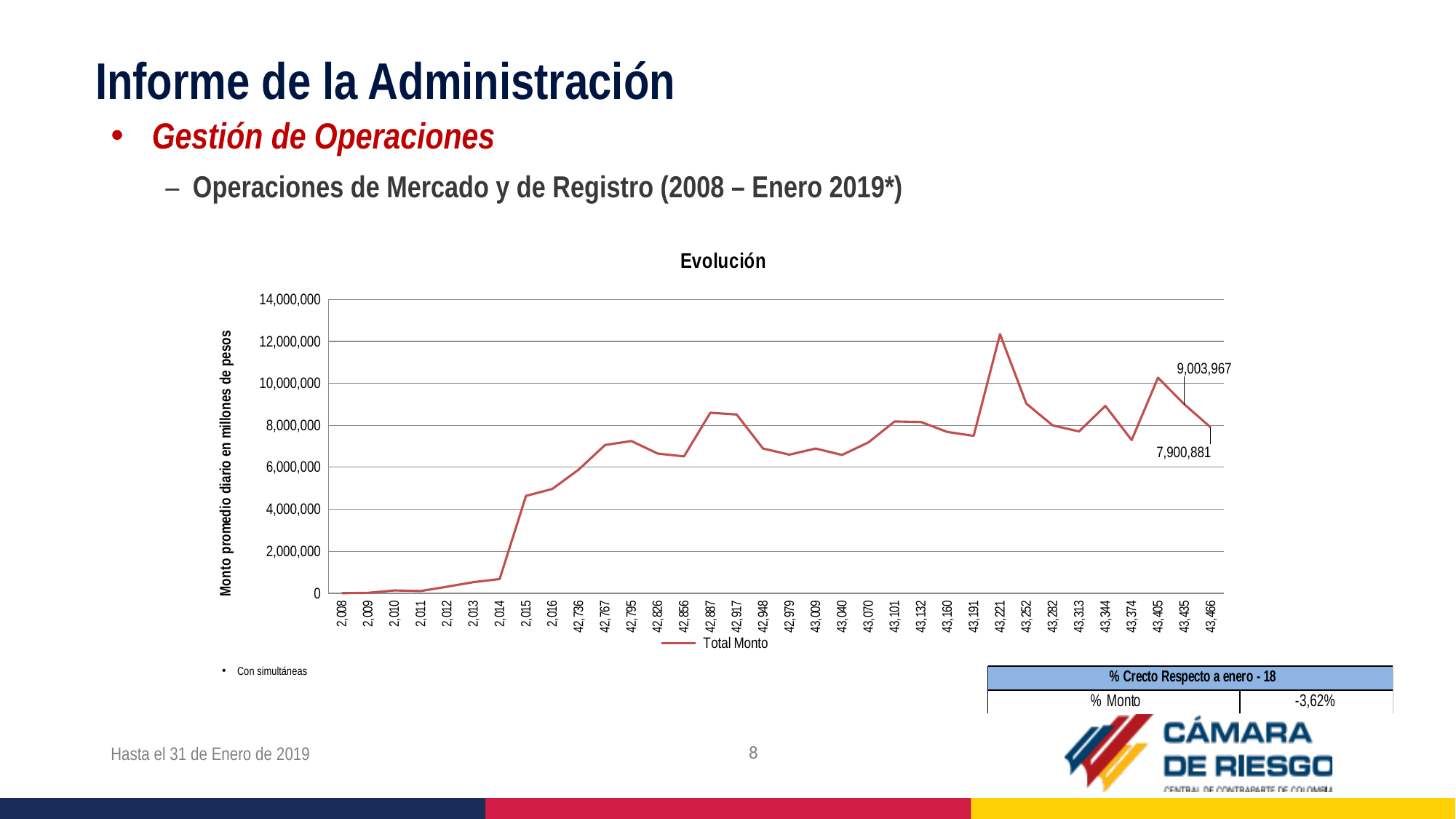
Is the Total Monto value at 2,014 greater or less than 2,000,000? less What is the y-axis title of the "Evolución" chart? Monto promedio diario en millones de pesos How many series does the legend of the "Evolución" chart list? 1 Is the Total Monto value at 43,405 greater or less than 10,000,000? greater What type of chart is the "Evolución" chart? line chart Is the Total Monto value at 43,221 greater or less than 12,000,000? greater Which of the two labelled points, 43,435 or 43,466, has the larger Total Monto value? 43,435 What is the value of Total Monto at 43,435? 9,003,967 At which x-axis label does Total Monto reach its highest value? 43,221 Does Total Monto rise or fall from 2,008 to 2,016? rise What is the difference between the Total Monto values at 43,435 and 43,466? 1,103,086 What is the value of Total Monto at 43,466? 7,900,881